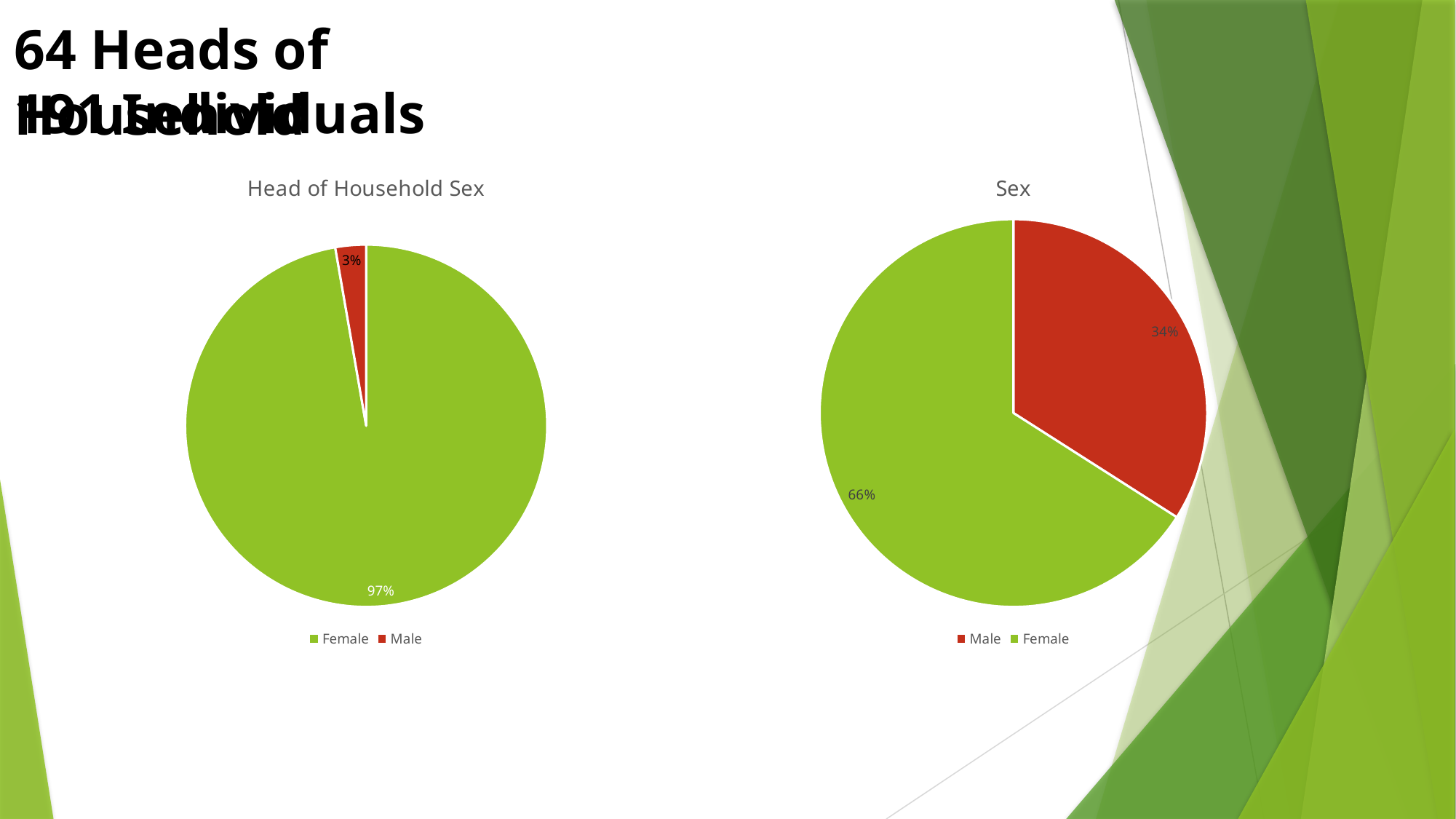
In the 'Head of Household Sex' chart, what is the difference between the Female and Male shares? 94% What kind of chart is the 'Sex' chart? Pie chart In the 'Sex' chart, what colour is the Male slice? Red In the 'Sex' chart, what share of the pie is Female? 66% In the 'Sex' chart, what is the difference between the Female and Male shares? 32% How many categories does the 'Head of Household Sex' chart show? 2 In the 'Sex' chart, which is larger, Male or Female? Female In the 'Sex' chart, what share of the pie is Male? 34% In the 'Head of Household Sex' chart, what share of the pie is Male? 3% In the 'Sex' chart, which category has the smallest slice? Male In the 'Head of Household Sex' chart, which category has the largest slice? Female